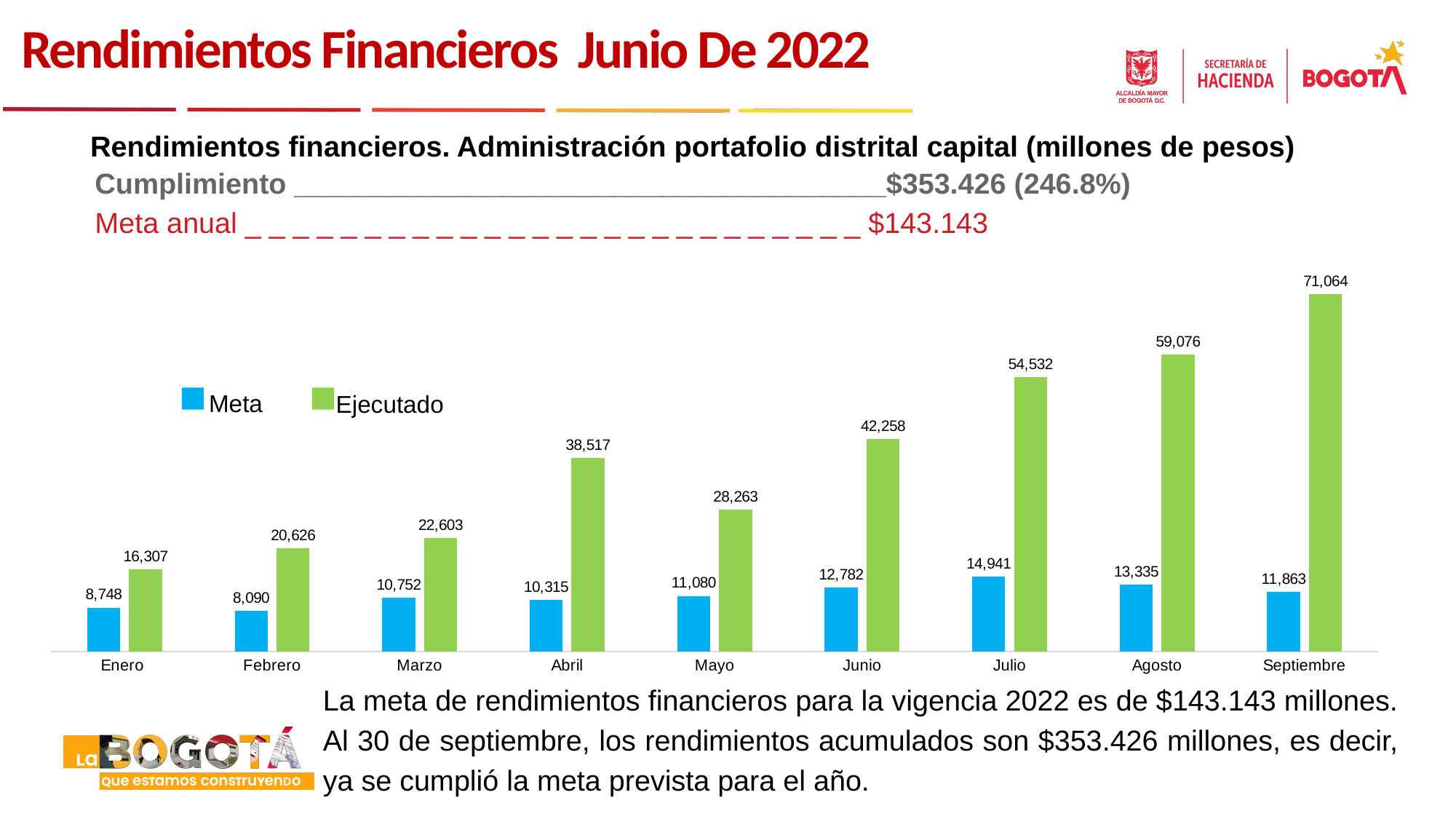
What is the difference between the Ejecutado and Meta values for Septiembre? 59,201 Which is larger, the Ejecutado value for Abril or the Ejecutado value for Mayo? Abril How many series does the chart legend list? 2 What is the Ejecutado value for Abril? 38,517 What is the Meta value for Julio? 14,941 Which month has the lowest Meta value? Febrero Which month has the highest Ejecutado value? Septiembre What kind of chart is shown on the slide? Bar chart Does the Ejecutado value rise or fall from Junio to Septiembre? Rise How many months are shown on the x axis of the chart? 9 Which month has the lowest Ejecutado value? Enero What is the Ejecutado value for Septiembre? 71,064